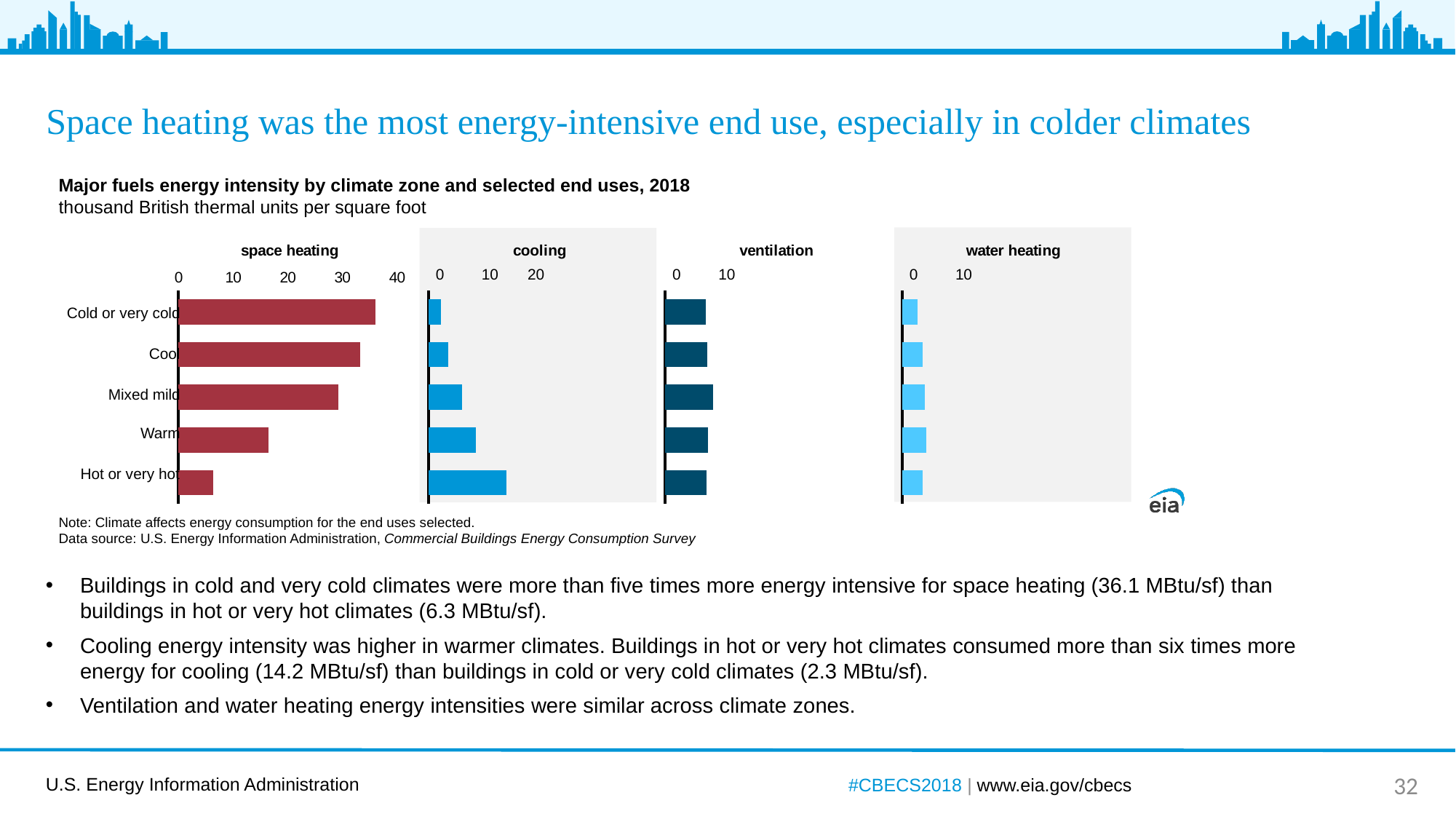
In the space heating panel, what is the difference between the Cold or very cold value (36.1 MBtu/sf) and the Hot or very hot value (6.3 MBtu/sf)? 29.8 MBtu/sf In the space heating panel, what is the energy intensity for Cold or very cold climates in MBtu/sf? 36.1 MBtu/sf In the space heating panel, which climate zone has the highest energy intensity? Cold or very cold In the space heating panel, do the values rise or fall moving from Cold or very cold down to Hot or very hot? fall In the space heating panel, is the value for Warm greater or less than 20? less In the cooling panel, which climate zone has the lowest energy intensity? Cold or very cold What kind of chart is used on this slide? bar chart In the cooling panel, which climate zone has the highest energy intensity? Hot or very hot In the space heating panel, which climate zone has the lowest energy intensity? Hot or very hot In the cooling panel, what is the energy intensity for Hot or very hot climates in MBtu/sf? 14.2 MBtu/sf In the cooling panel, is the value for Warm greater or less than 10? less How many climate zone categories are shown in each panel? 5